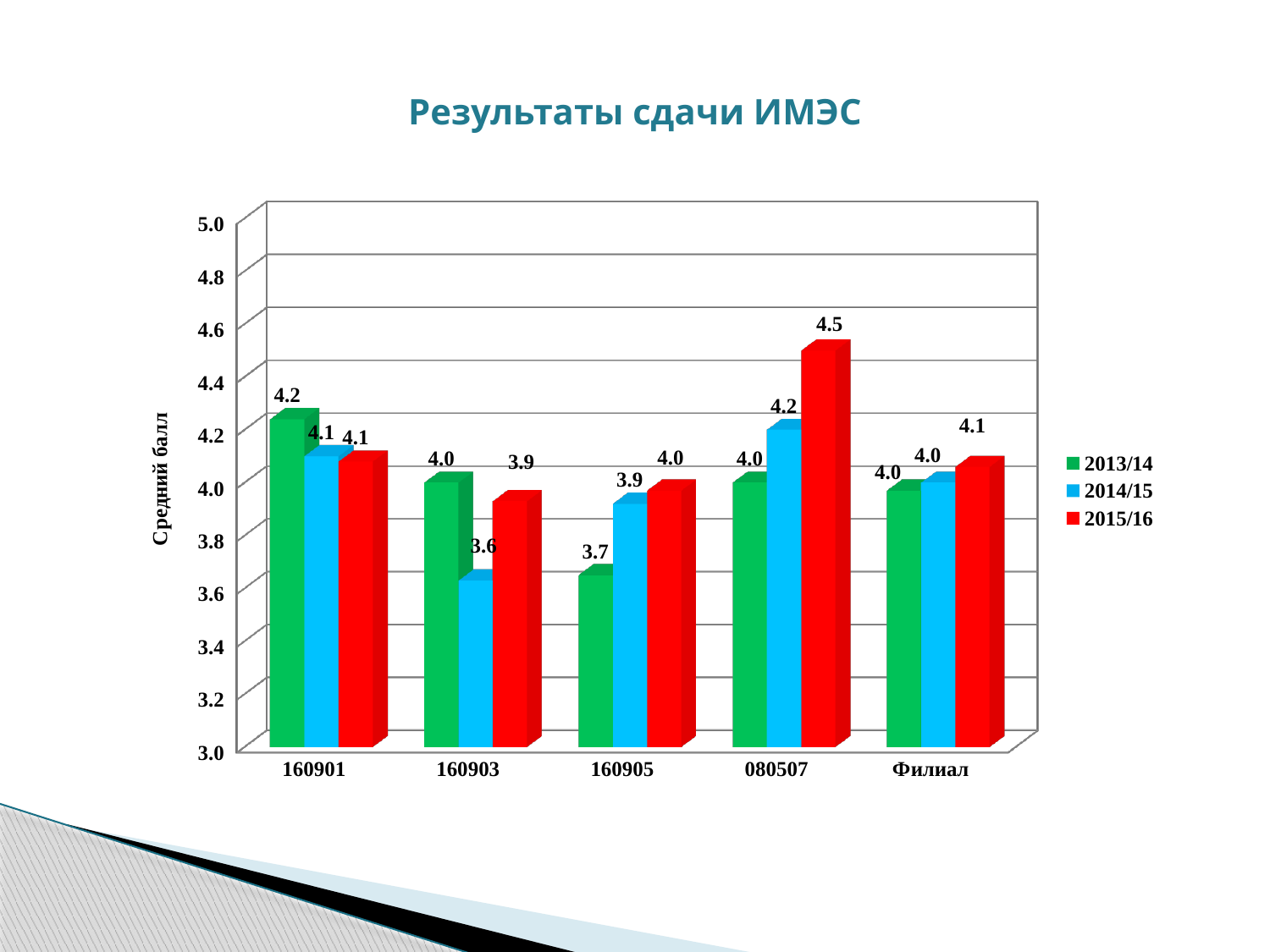
What is the value for 2013/14 for category 160905? 3.7 What is the value for 2014/15 for category 160903? 3.6 What is the difference between the 2015/16 and 2013/14 values for category 080507? 0.5 How many categories are shown on the x axis? 5 What is the value for 2015/16 for category 080507? 4.5 How many series does the legend list? 3 What is the label of the vertical axis? Средний балл Which category has the highest value for the 2015/16 series? 080507 Which is larger for category 160903: the 2013/14 value or the 2014/15 value? 2013/14 What kind of chart is shown on the slide? Bar chart Which category has the lowest value for the 2014/15 series? 160903 What is the value for 2015/16 for category Филиал? 4.1